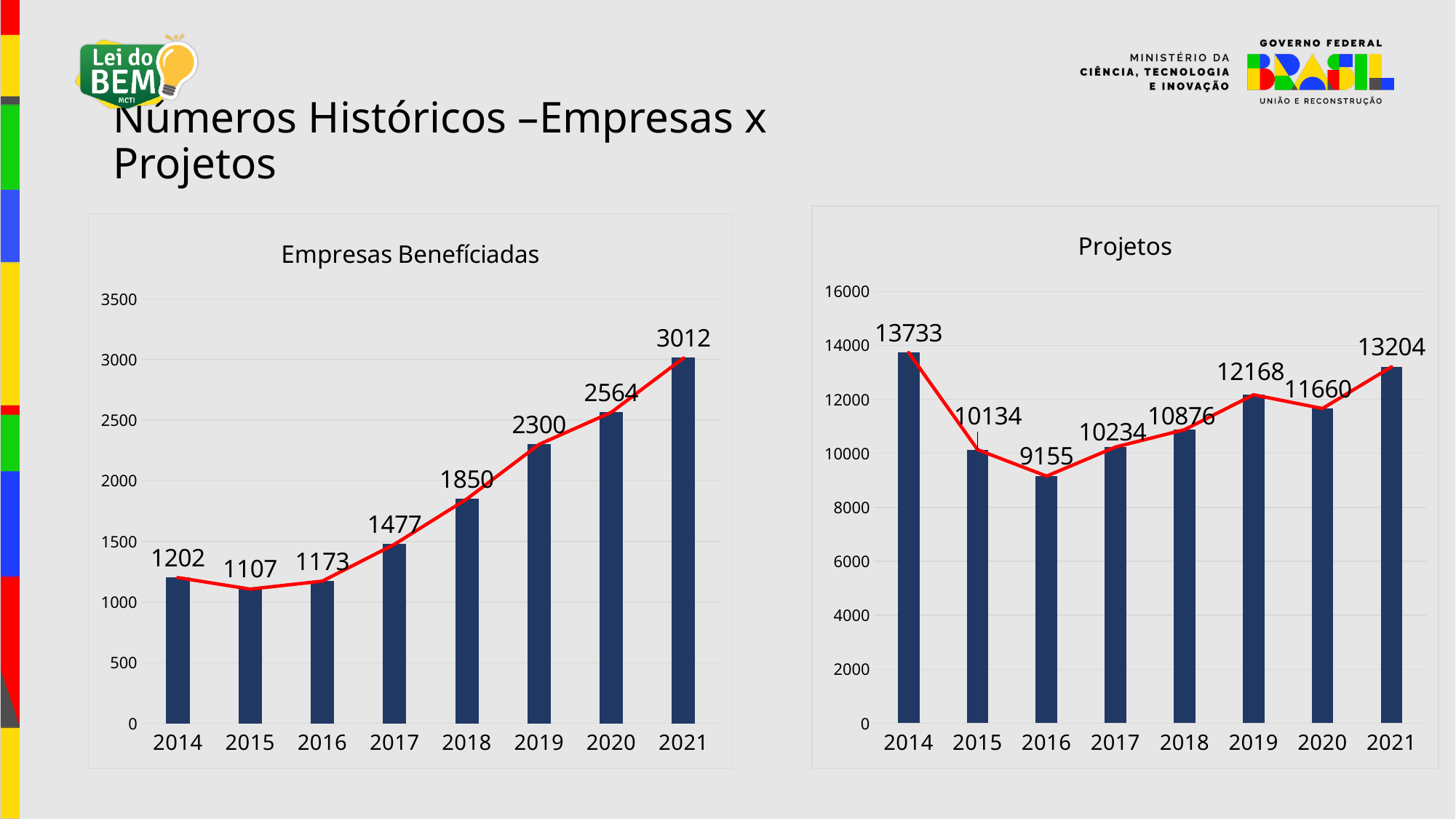
In the 'Projetos' chart, what is the difference between the values for 2019 and 2020? 508 In the 'Empresas Benefíciadas' chart, what is the value for 2018? 1850 In the 'Projetos' chart, which is larger, the value for 2014 or the value for 2021? 2014 In the 'Empresas Benefíciadas' chart, what is the difference between the values for 2021 and 2020? 448 In the 'Empresas Benefíciadas' chart, which year has the highest value? 2021 In the 'Empresas Benefíciadas' chart, do the values generally rise or fall from 2016 to 2021? Rise How many years are shown on the x axis of the 'Empresas Benefíciadas' chart? 8 In the 'Empresas Benefíciadas' chart, which year has the lowest value? 2015 In the 'Projetos' chart, which year has the highest value? 2014 In the 'Projetos' chart, what is the value for 2016? 9155 What kind of chart is the 'Projetos' chart? Bar chart with a line overlay In the 'Projetos' chart, which year has the lowest value? 2016